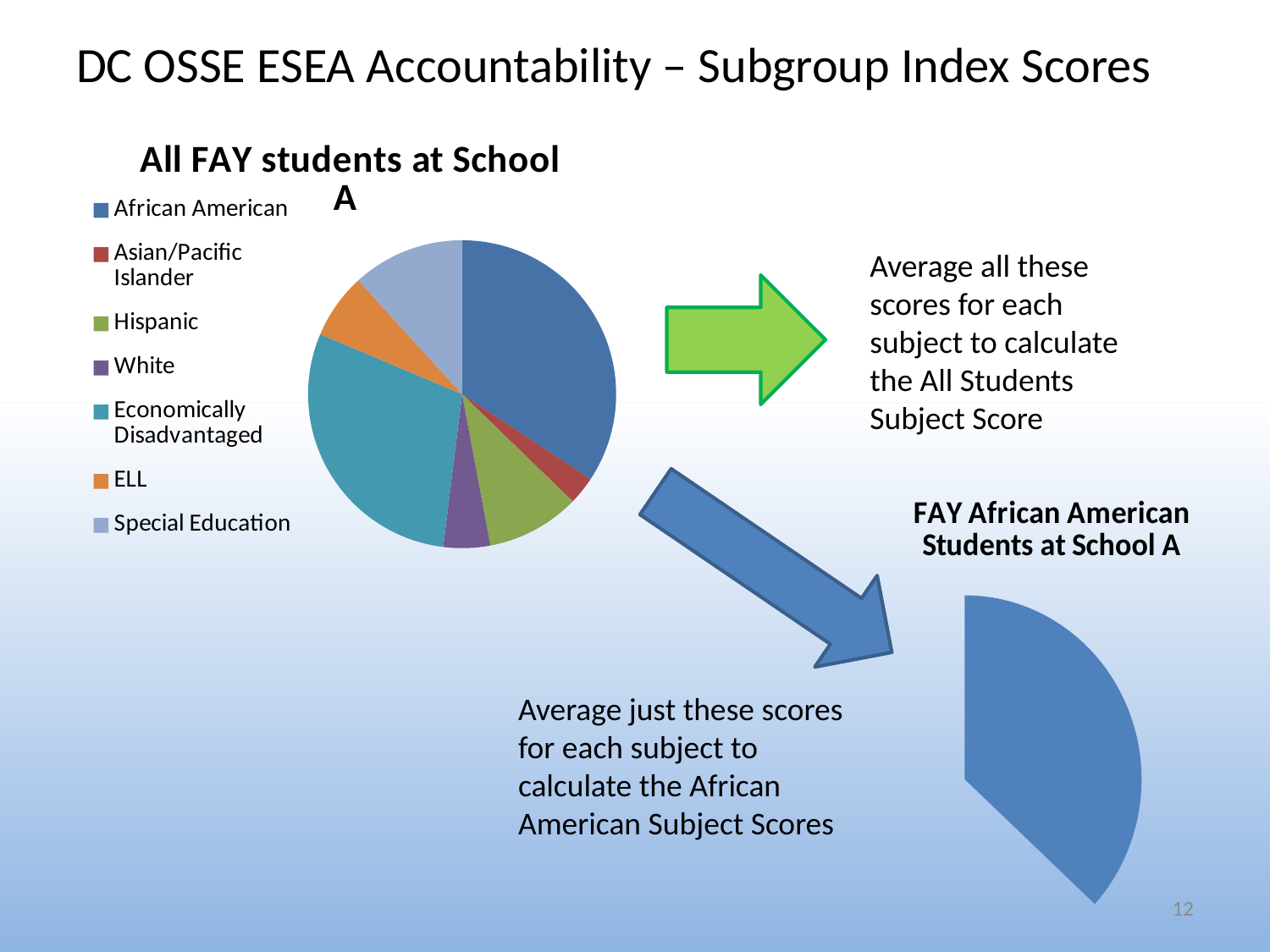
What kind of chart is the "All FAY students at School A" chart? pie chart In the "All FAY students at School A" pie chart, which category is shown in orange? ELL In the "All FAY students at School A" pie chart, which slice is larger: Special Education or ELL? Special Education In the "All FAY students at School A" pie chart, which slice is larger: Economically Disadvantaged or Special Education? Economically Disadvantaged Which category has the largest slice in the "All FAY students at School A" pie chart? African American How many categories does the "All FAY students at School A" pie chart show? 7 Which category has the smallest slice in the "All FAY students at School A" pie chart? Asian/Pacific Islander In the "All FAY students at School A" pie chart, which slice is larger: Hispanic or White? Hispanic What is the title of the pie chart on the left of the slide? All FAY students at School A